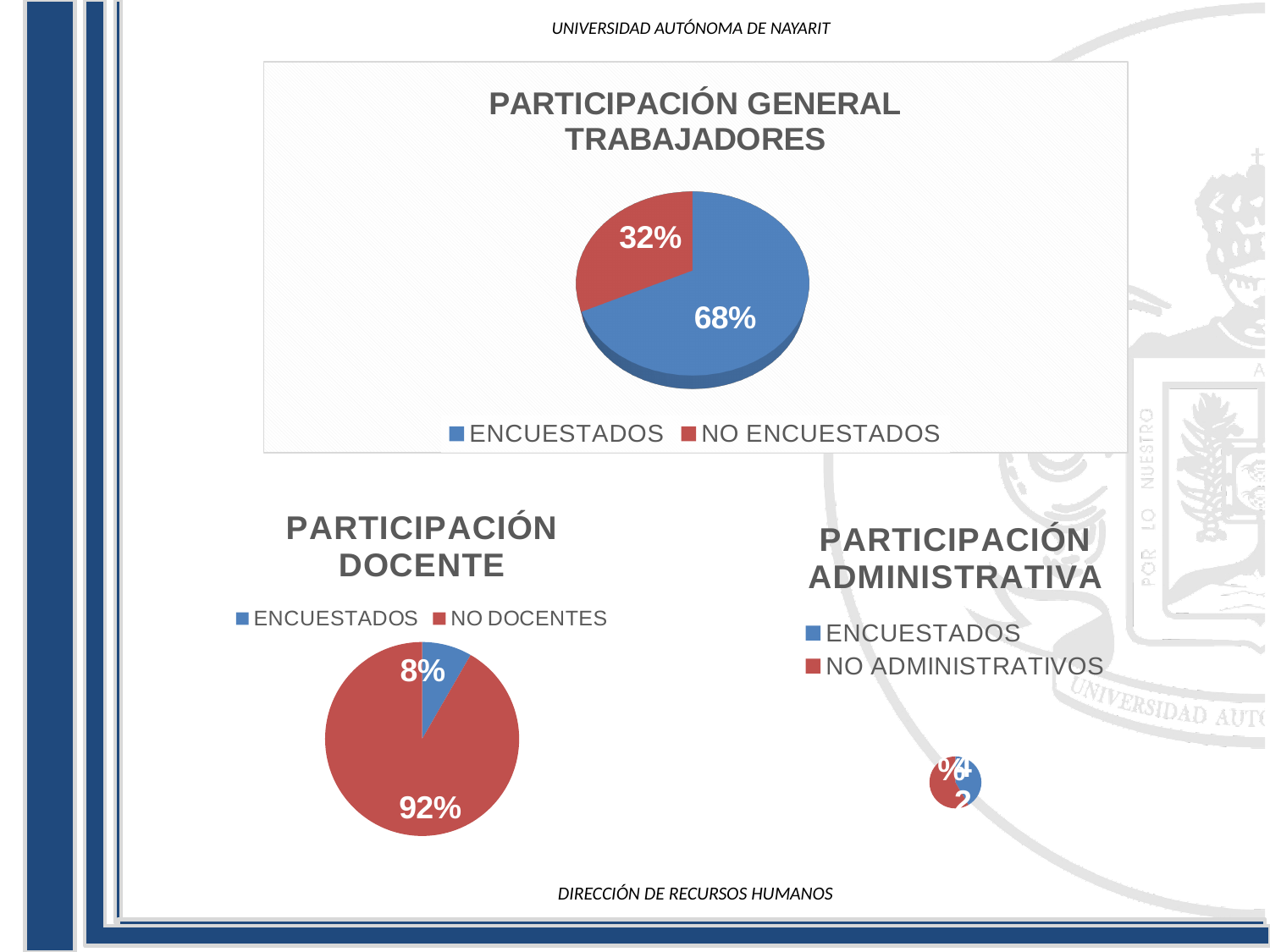
In the PARTICIPACIÓN DOCENTE chart, what share of the pie is NO DOCENTES? 92% In the PARTICIPACIÓN GENERAL TRABAJADORES chart, what share of the pie is NO ENCUESTADOS? 32% In the PARTICIPACIÓN DOCENTE chart, what share of the pie is ENCUESTADOS? 8% In the PARTICIPACIÓN DOCENTE chart, what is the difference in percentage points between NO DOCENTES and ENCUESTADOS? 84 In the PARTICIPACIÓN GENERAL TRABAJADORES chart, which slice is larger, ENCUESTADOS or NO ENCUESTADOS? ENCUESTADOS How many series does the legend of the PARTICIPACIÓN ADMINISTRATIVA chart list? 2 What kind of chart is the PARTICIPACIÓN GENERAL TRABAJADORES chart? Pie chart In the PARTICIPACIÓN GENERAL TRABAJADORES chart, what is the difference in percentage points between ENCUESTADOS and NO ENCUESTADOS? 36 In the PARTICIPACIÓN DOCENTE chart, which slice is the largest? NO DOCENTES What are the two legend entries of the PARTICIPACIÓN ADMINISTRATIVA chart? ENCUESTADOS and NO ADMINISTRATIVOS In the PARTICIPACIÓN DOCENTE chart, which slice is the smallest? ENCUESTADOS